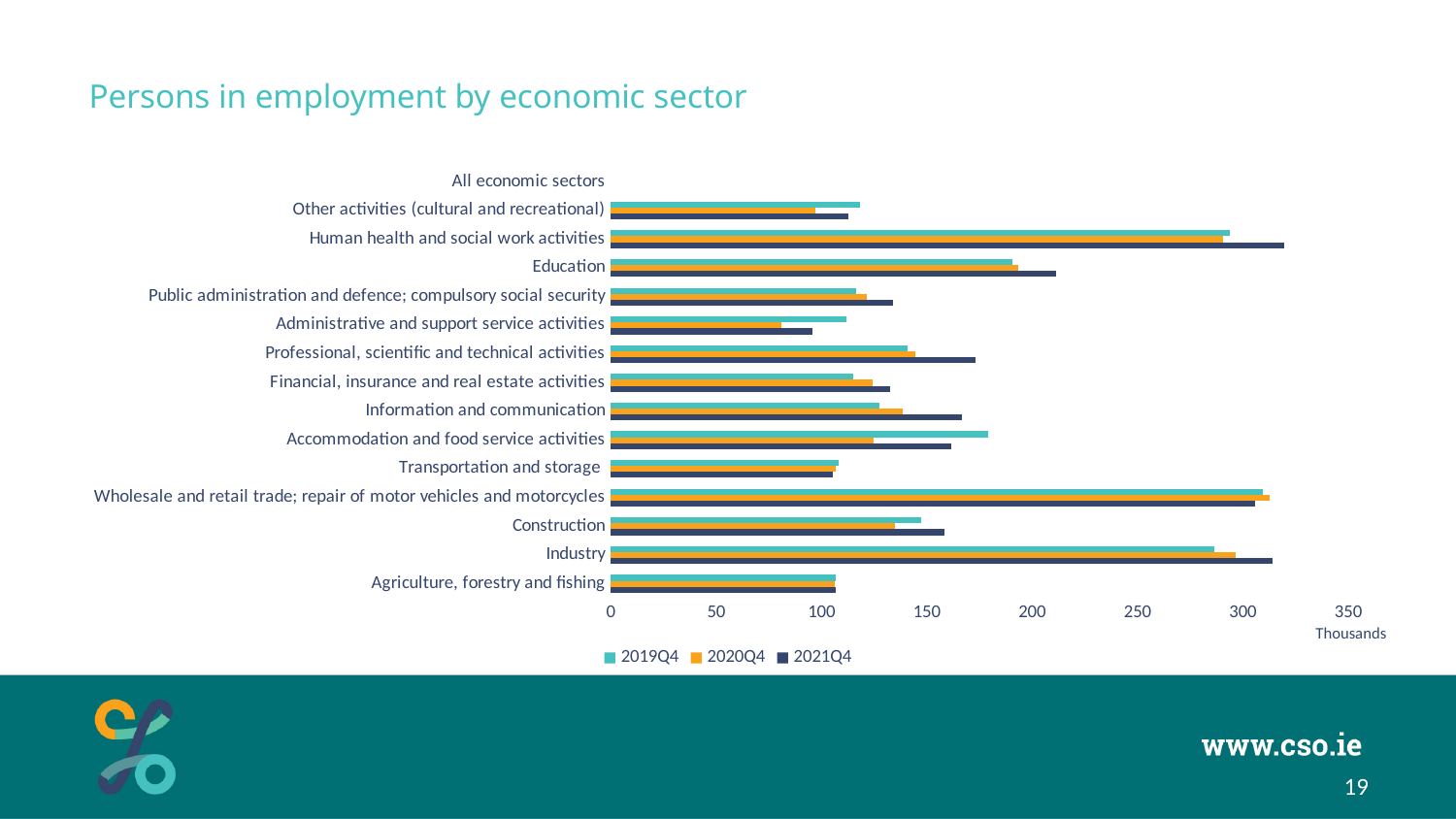
For Information and communication, which is larger: the 2019Q4 value or the 2021Q4 value? 2021Q4 Which sector has the lowest 2020Q4 value? Administrative and support service activities Is the 2021Q4 value for Education greater or less than 200? greater How many series does the legend list? 3 Is the 2020Q4 value for Construction greater or less than 150? less What kind of chart is shown on the slide? Bar chart Which series are listed in the legend? 2019Q4, 2020Q4, 2021Q4 Is the 2019Q4 value for Accommodation and food service activities greater or less than 150? greater For Accommodation and food service activities, which is larger: the 2019Q4 value or the 2020Q4 value? 2019Q4 What unit is shown on the horizontal axis? Thousands